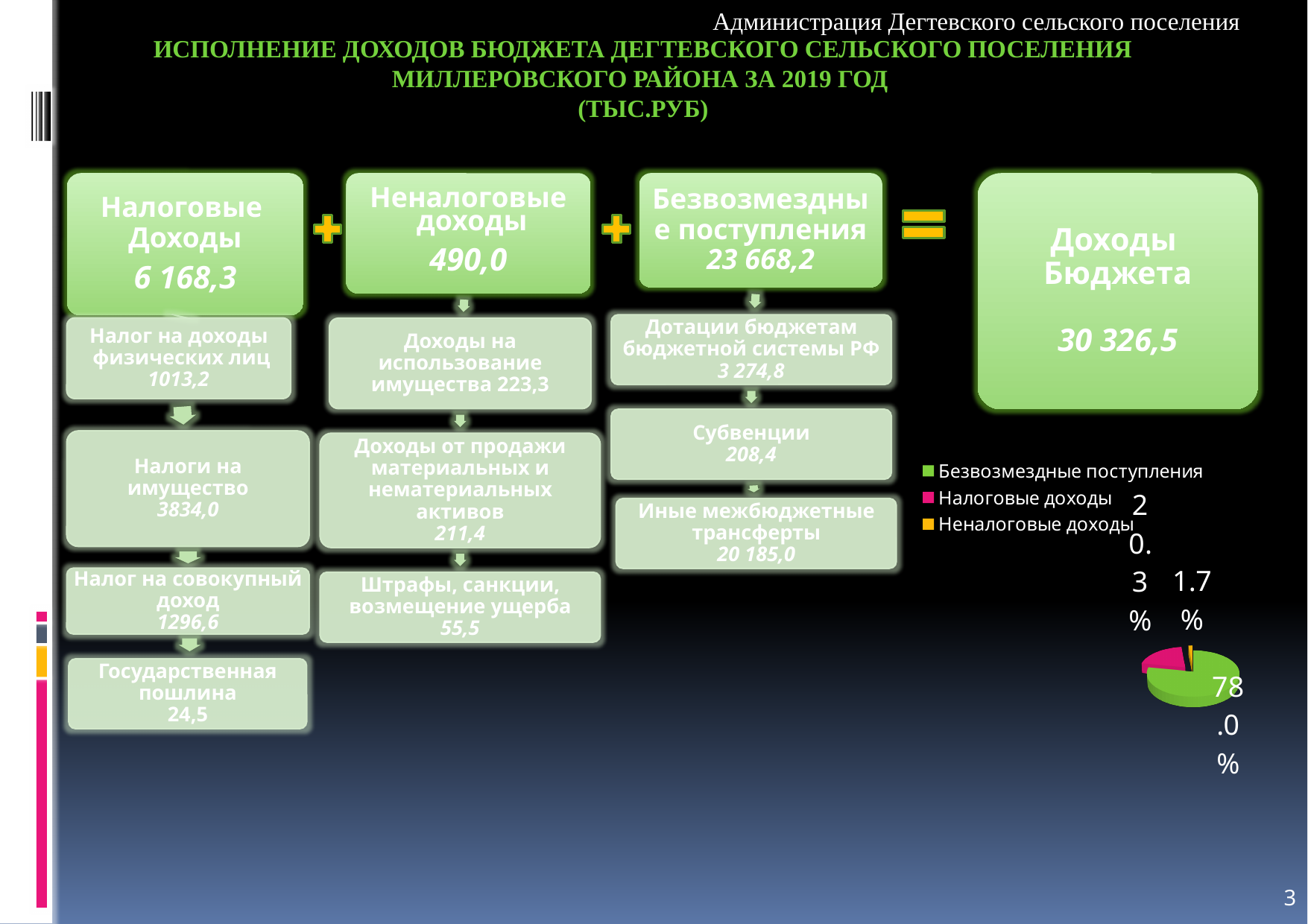
Which category has the smallest slice in the pie chart? Неналоговые доходы In the pie chart, what share is shown for Налоговые доходы? 20.3% In the pie chart, what is the difference between the shares of Безвозмездные поступления and Налоговые доходы? 57.7% How many slices does the pie chart have? 3 In the pie chart, what share is shown for Безвозмездные поступления? 78.0% In the pie chart, what share is shown for Неналоговые доходы? 1.7% What colour is the Безвозмездные поступления slice in the pie chart? green In the pie chart, which is larger: Налоговые доходы or Неналоговые доходы? Налоговые доходы What colour is the Налоговые доходы slice in the pie chart? pink What kind of chart is shown in the bottom right of the slide? pie chart How many entries does the pie chart legend list? 3 Which category has the largest slice in the pie chart? Безвозмездные поступления